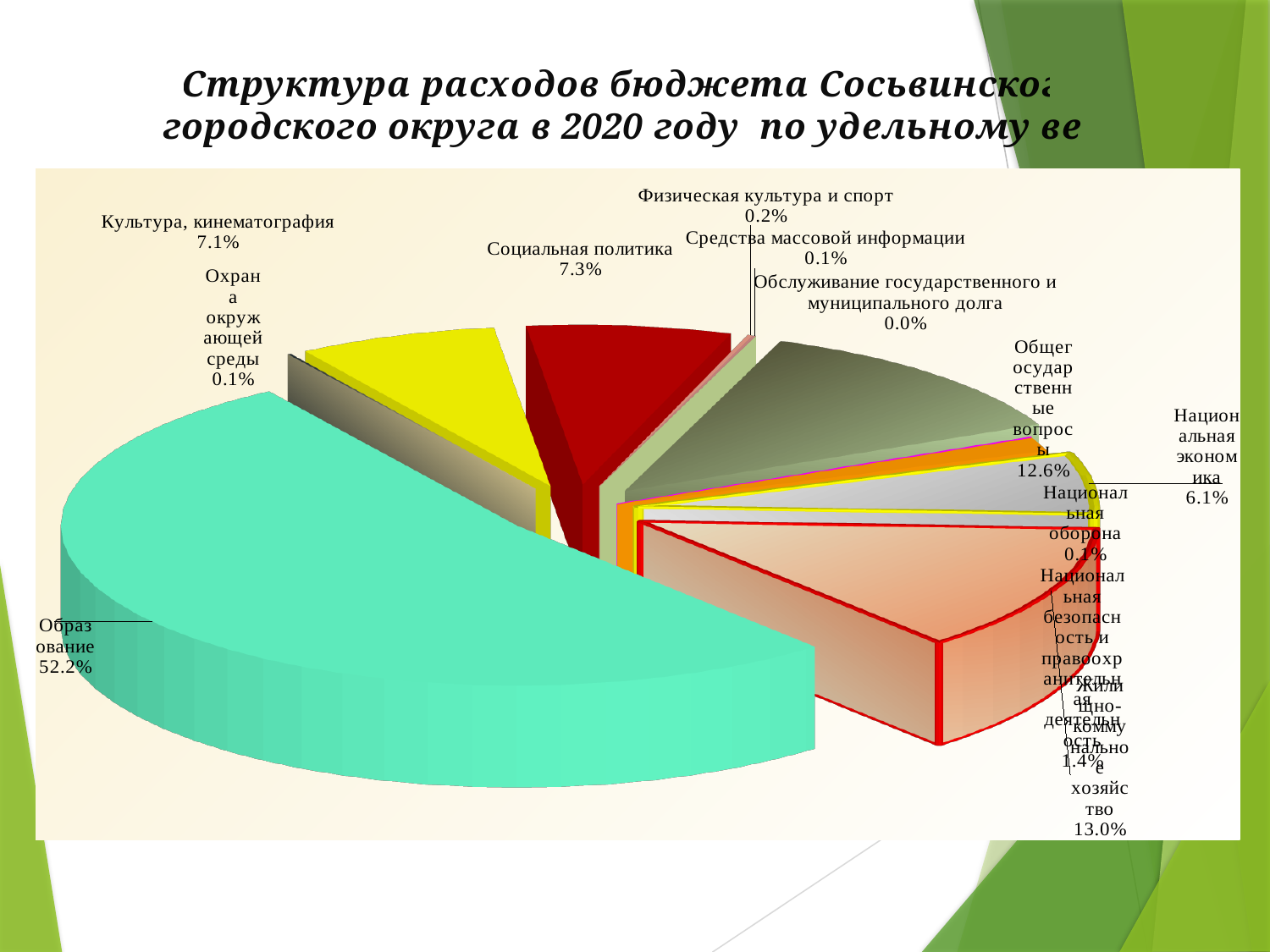
What is the difference between the shares of Жилищно-коммунальное хозяйство and Общегосударственные вопросы? 0.4% What share of the pie does Образование account for? 52.2% Which category has the largest share of the pie? Образование What is the value shown for Жилищно-коммунальное хозяйство? 13.0% What is the value shown for Социальная политика? 7.3% What colour is the Образование slice? Turquoise What kind of chart is shown on the slide? Pie chart What is the value shown for Общегосударственные вопросы? 12.6% Which is larger, Социальная политика or Культура, кинематография? Социальная политика Which category has the smallest share of the pie? Обслуживание государственного и муниципального долга What is the value shown for Национальная экономика? 6.1% How many categories are shown in the pie chart? 12